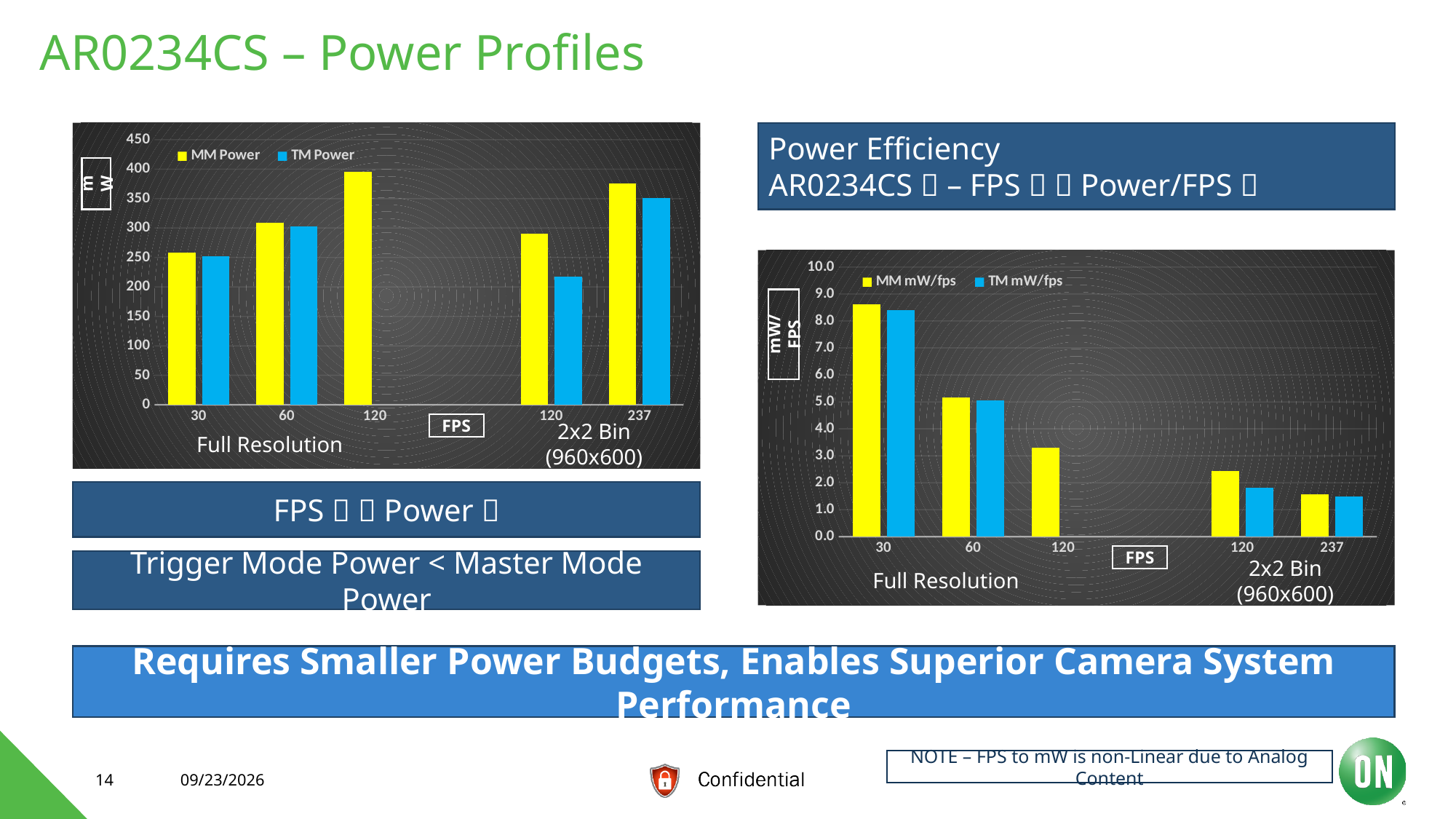
In the left chart (MM Power / TM Power), is the TM Power value at 120 fps 2x2 Bin greater or less than 250? less In the right chart (MM mW/fps / TM mW/fps), is the MM mW/fps value at 30 fps greater or less than 8.0? greater In the left chart (MM Power / TM Power), how many series does the legend list? 2 In the left chart (MM Power / TM Power), at which FPS is MM Power highest? 120 (Full Resolution) In the right chart (MM mW/fps / TM mW/fps), how many series does the legend list? 2 In the left chart (MM Power / TM Power), which is larger at 120 fps 2x2 Bin: MM Power or TM Power? MM Power In the left chart (MM Power / TM Power), what is the y-axis unit label? mW In the right chart (MM mW/fps / TM mW/fps), at which FPS is TM mW/fps lowest? 237 (2x2 Bin) What kind of chart is the left chart showing MM Power and TM Power? bar chart In the left chart (MM Power / TM Power), is the MM Power value at 120 fps Full Resolution greater or less than 350? greater In the right chart (MM mW/fps / TM mW/fps), does MM mW/fps rise or fall as FPS increases across the Full Resolution categories? fall In the right chart (MM mW/fps / TM mW/fps), how many FPS categories are shown on the x axis? 5